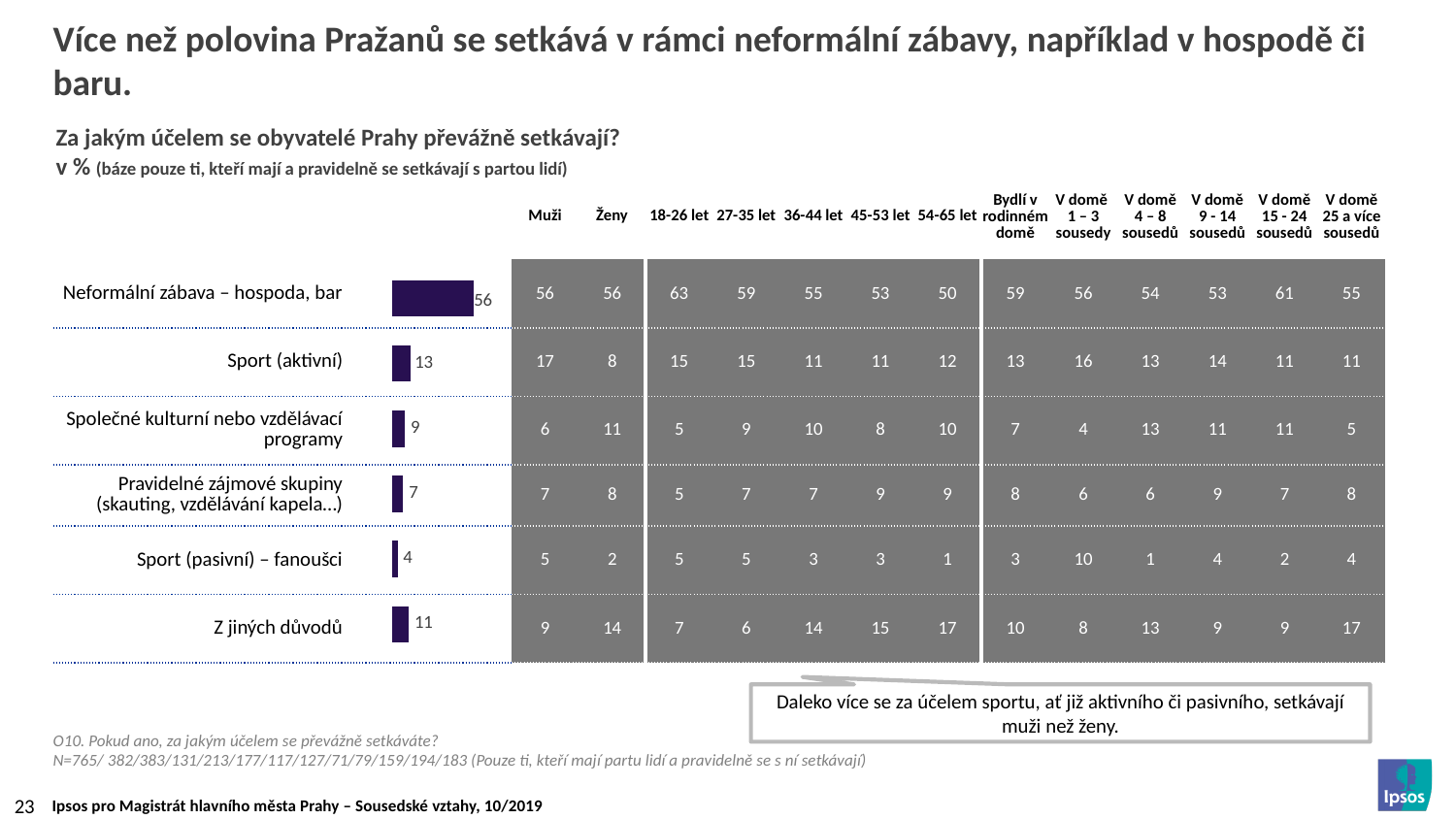
Which category has the highest value in the bar chart? Neformální zábava – hospoda, bar What value is shown for 'Sport (pasivní) – fanoušci' in the bar chart? 4 Which is larger: the value for 'Společné kulturní nebo vzdělávací programy' or for 'Pravidelné zájmové skupiny (skauting, vzdělávání kapela…)'? Společné kulturní nebo vzdělávací programy What is the difference between the values for 'Neformální zábava – hospoda, bar' and 'Sport (aktivní)'? 43 What value is shown for 'Sport (aktivní)' in the bar chart? 13 What is the difference between the values for 'Z jiných důvodů' and 'Sport (pasivní) – fanoušci'? 7 What value is shown for 'Z jiných důvodů' in the bar chart? 11 How many categories are shown in the bar chart? 6 What value is shown for 'Neformální zábava – hospoda, bar' in the bar chart? 56 What is the title of the chart on the slide? Za jakým účelem se obyvatelé Prahy převážně setkávají? Which category has the lowest value in the bar chart? Sport (pasivní) – fanoušci What kind of chart is shown on the slide? Bar chart